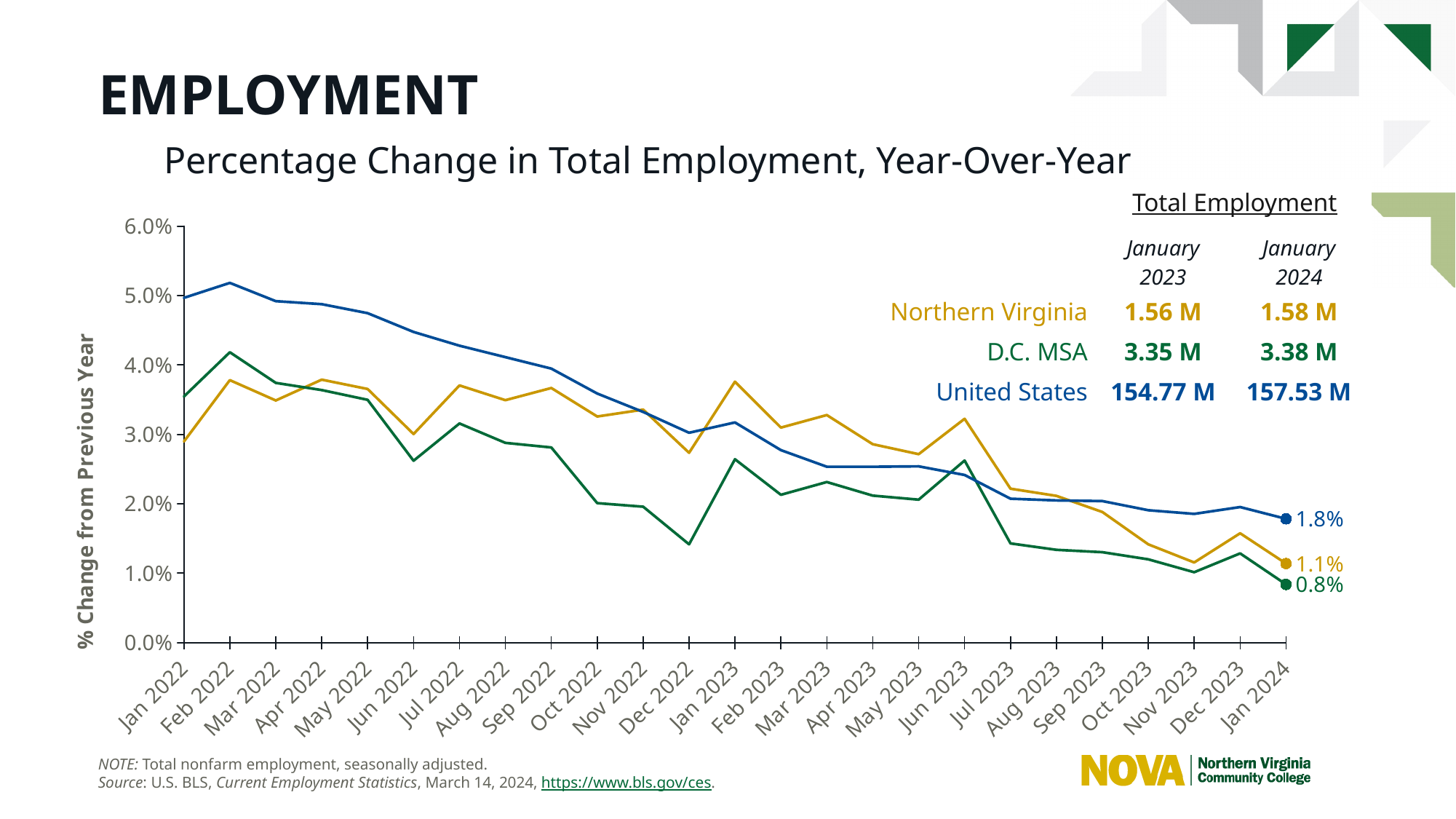
What is the value for Northern Virginia in Jan 2024? 1.1% Which series has the lowest value in Jan 2024? D.C. MSA How many months are plotted along the x axis? 25 Is the value for D.C. MSA in Dec 2022 greater or less than 2.0%? less What is the difference between the United States and D.C. MSA values in Jan 2024? 1.0% What kind of chart is shown on the slide? Line chart Which series has the highest value in Jan 2024? United States In Jan 2024, which is larger: the value for United States or the value for Northern Virginia? United States How many series are plotted on the chart? 3 What is the value for United States in Jan 2024? 1.8% Is the value for United States in Jan 2022 greater or less than 4.0%? greater What is the value for D.C. MSA in Jan 2024? 0.8%